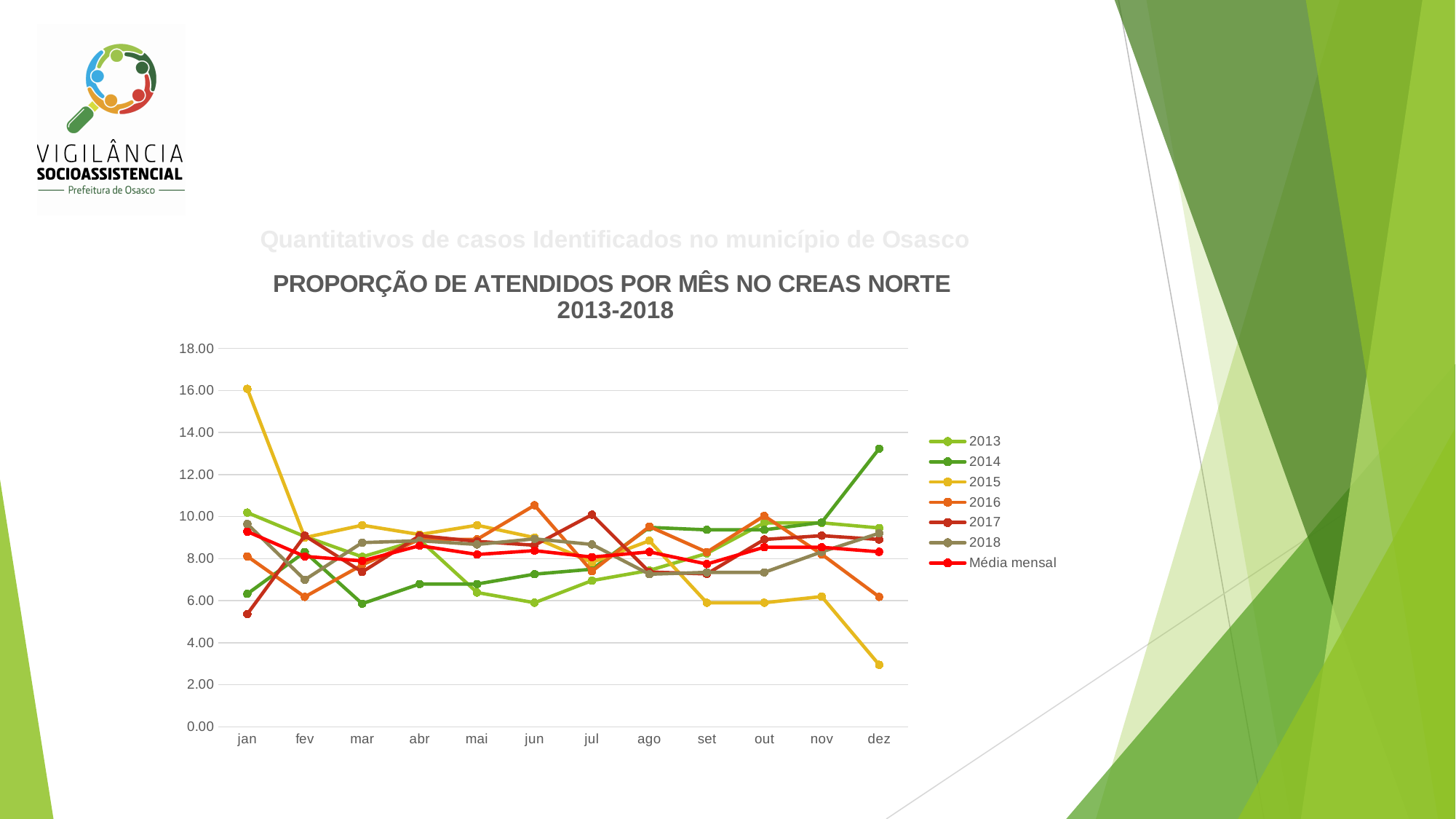
Is the value for 2015 in dez greater or less than 4.00? less In which month does the 2014 series reach its highest value? dez What kind of chart is shown on the slide? line chart Which is larger in jan: the value for 2015 or the value for 2014? 2015 How many months are shown along the x axis? 12 Which series is drawn in red in the legend? Média mensal How many series does the legend list? 7 In which month does the 2015 series reach its lowest value? dez In which month does the 2015 series reach its highest value? jan In which month does the 2017 series reach its lowest value? jan Is the value for 2015 in jan greater or less than 14.00? greater Is the value for 2014 in dez greater or less than 12.00? greater